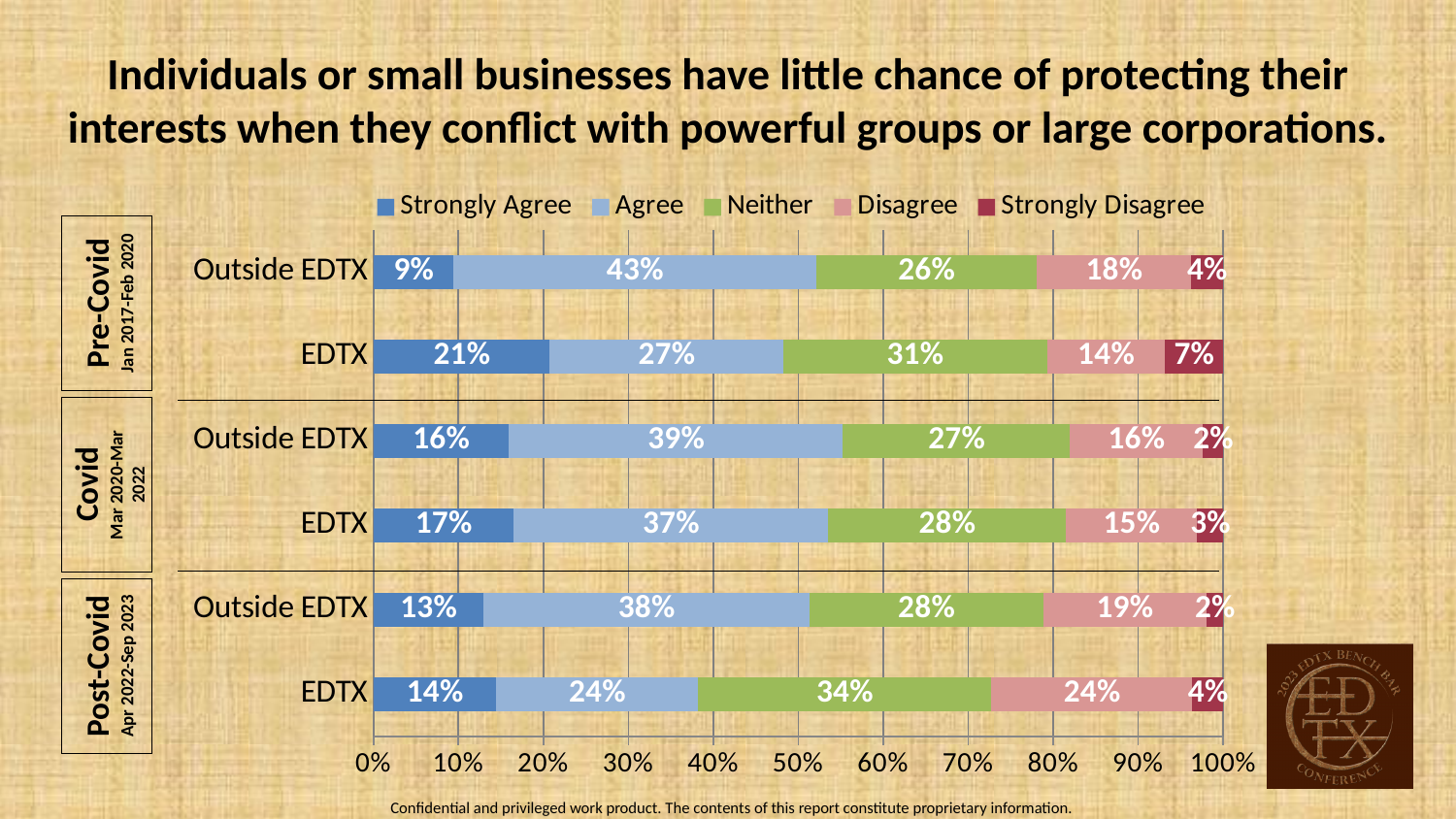
What is the Neither value for Covid EDTX? 28% Which bar has the highest Strongly Agree percentage? Pre-Covid EDTX How many series does the legend list? 5 What is the difference between the Agree percentages for Pre-Covid Outside EDTX and Pre-Covid EDTX? 16% How many bars are plotted in the chart? 6 What percentage of Post-Covid Outside EDTX respondents Disagree? 19% What kind of chart is shown on the slide? Stacked bar chart Which bar has the lowest Agree percentage? Post-Covid EDTX What is the combined Strongly Agree and Agree percentage for Covid Outside EDTX? 55% What percentage of Pre-Covid EDTX respondents Strongly Agree? 21% Which is larger: the Neither value for Post-Covid EDTX or the Neither value for Post-Covid Outside EDTX? Post-Covid EDTX Which legend entry is shown in green? Neither